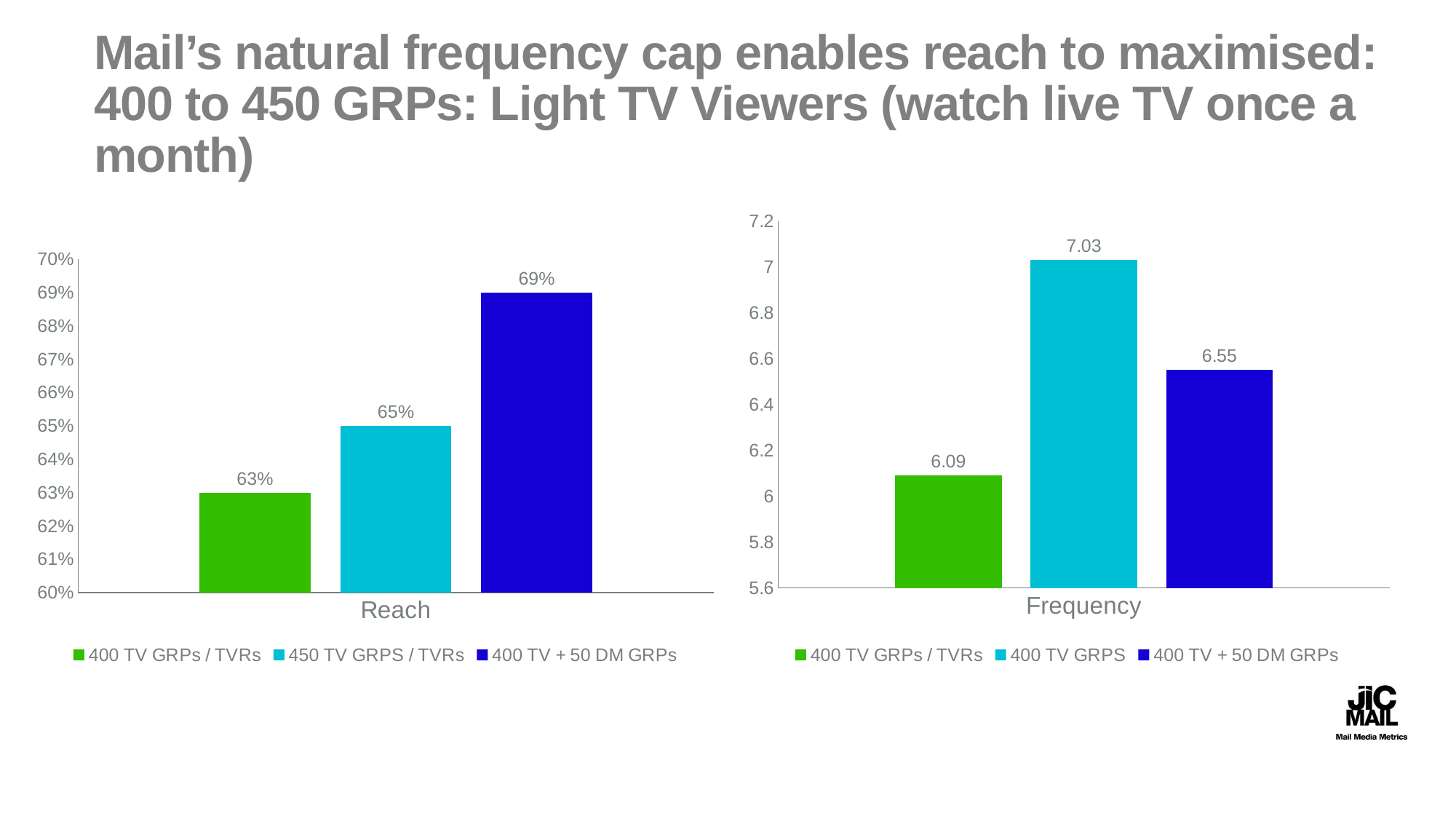
In the Reach chart on the left, what is the value for 400 TV + 50 DM GRPs? 69% In the Frequency chart on the right, what is the value for 400 TV + 50 DM GRPs? 6.55 In the Frequency chart on the right, what is the value for 400 TV GRPS? 7.03 In the Reach chart on the left, what colour is the bar for 450 TV GRPS / TVRs? Cyan (light blue) What kind of chart is the Frequency chart on the right? Bar chart In the Frequency chart on the right, which series has the lowest value? 400 TV GRPs / TVRs In the Reach chart on the left, what is the value for 400 TV GRPs / TVRs? 63% In the Reach chart on the left, what is the difference between the 400 TV + 50 DM GRPs value and the 450 TV GRPS / TVRs value? 4% How many series does the legend of the Reach chart on the left list? 3 In the Frequency chart on the right, what is the difference between the 400 TV GRPS value and the 400 TV GRPs / TVRs value? 0.94 In the Frequency chart on the right, which is larger: 400 TV GRPS or 400 TV + 50 DM GRPs? 400 TV GRPS In the Reach chart on the left, which series has the highest value? 400 TV + 50 DM GRPs